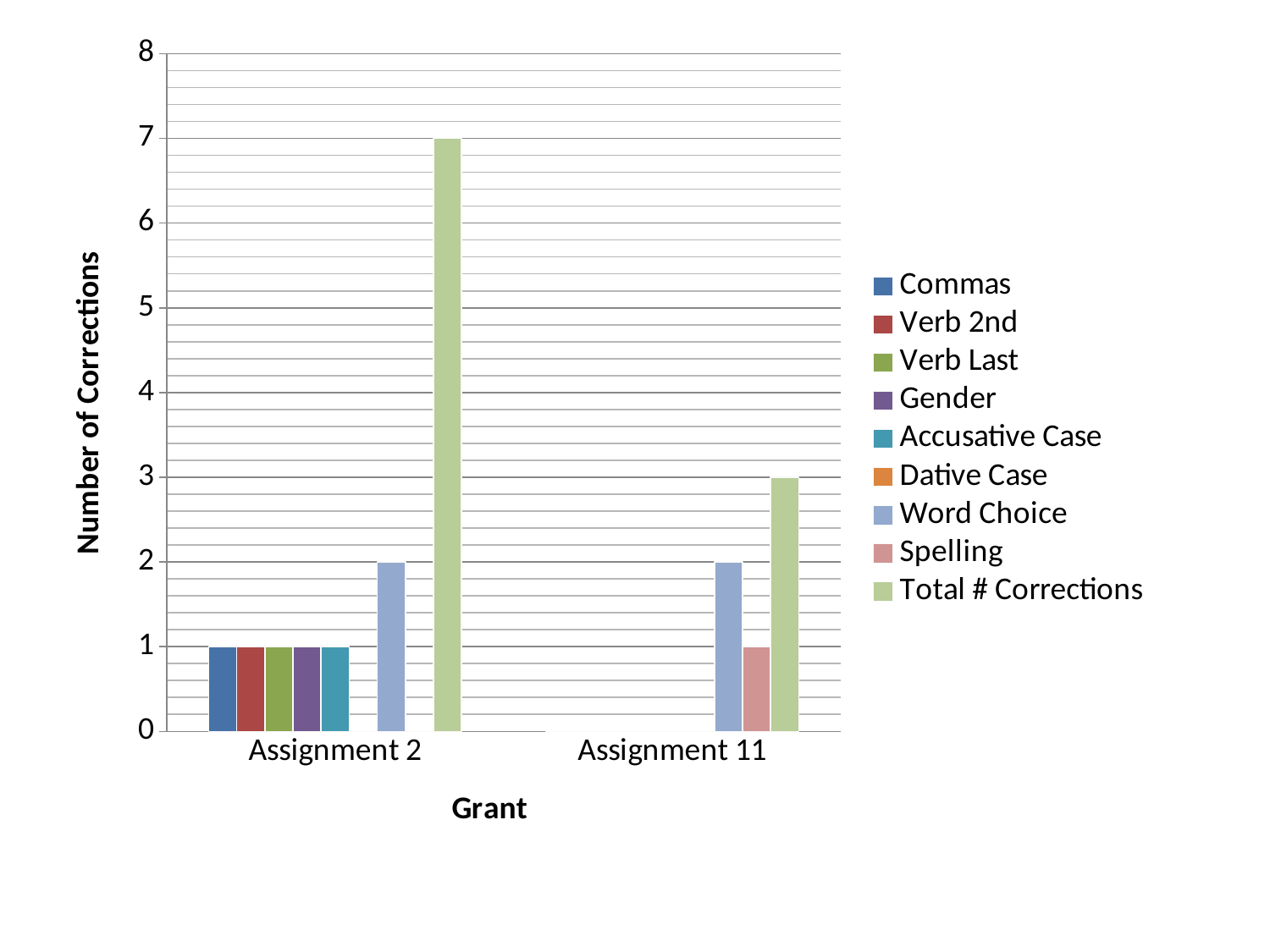
Which assignment has the higher Total # Corrections? Assignment 2 What is the Total # Corrections value for Assignment 2? 7 What is the Word Choice value for Assignment 2? 2 What is the Total # Corrections value for Assignment 11? 3 What is the Commas value for Assignment 2? 1 Is the Total # Corrections value for Assignment 2 greater or less than 6? greater What is the difference between the Total # Corrections for Assignment 2 and Assignment 11? 4 What type of chart is shown on the slide? bar chart What is the label of the y axis? Number of Corrections What is the Spelling value for Assignment 11? 1 How many series does the legend list? 9 How many categories are shown on the x axis? 2